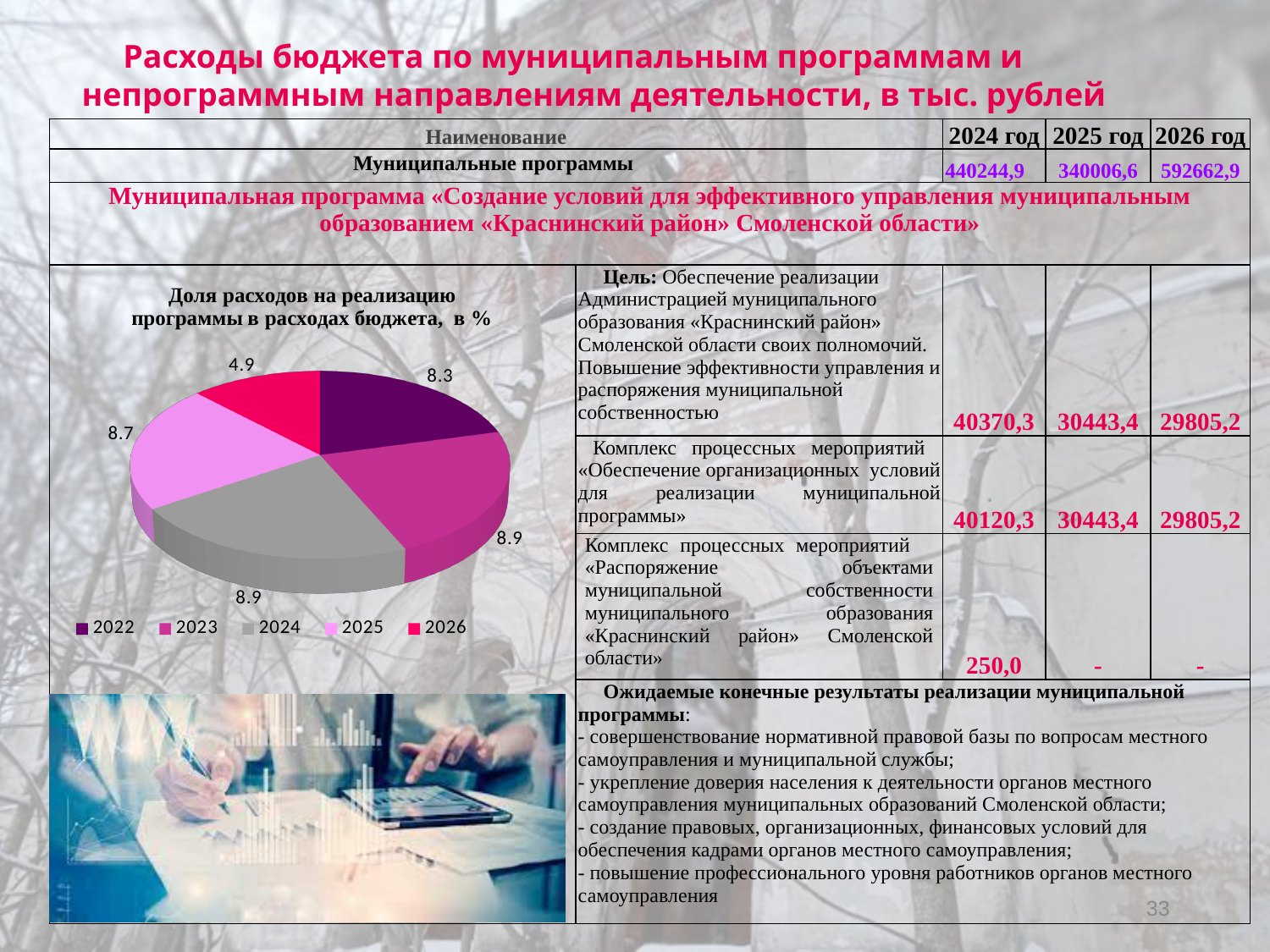
Which is larger in the pie chart, the value for 2022 or the value for 2026? 2022 What is the value shown for 2025 in the pie chart? 8.7 What is the value shown for 2026 in the pie chart? 4.9 Which year has the smallest slice in the pie chart? 2026 What is the difference between the values for 2025 and 2022 in the pie chart? 0.4 What is the value shown for 2023 in the pie chart? 8.9 What is the difference between the values for 2025 and 2026 in the pie chart? 3.8 What kind of chart is shown on the slide? Pie chart What is the value shown for 2022 in the pie chart? 8.3 How many slices does the pie chart have? 5 How many entries does the legend of the pie chart list? 5 What is the title of the pie chart? Доля расходов на реализацию программы в расходах бюджета, в %